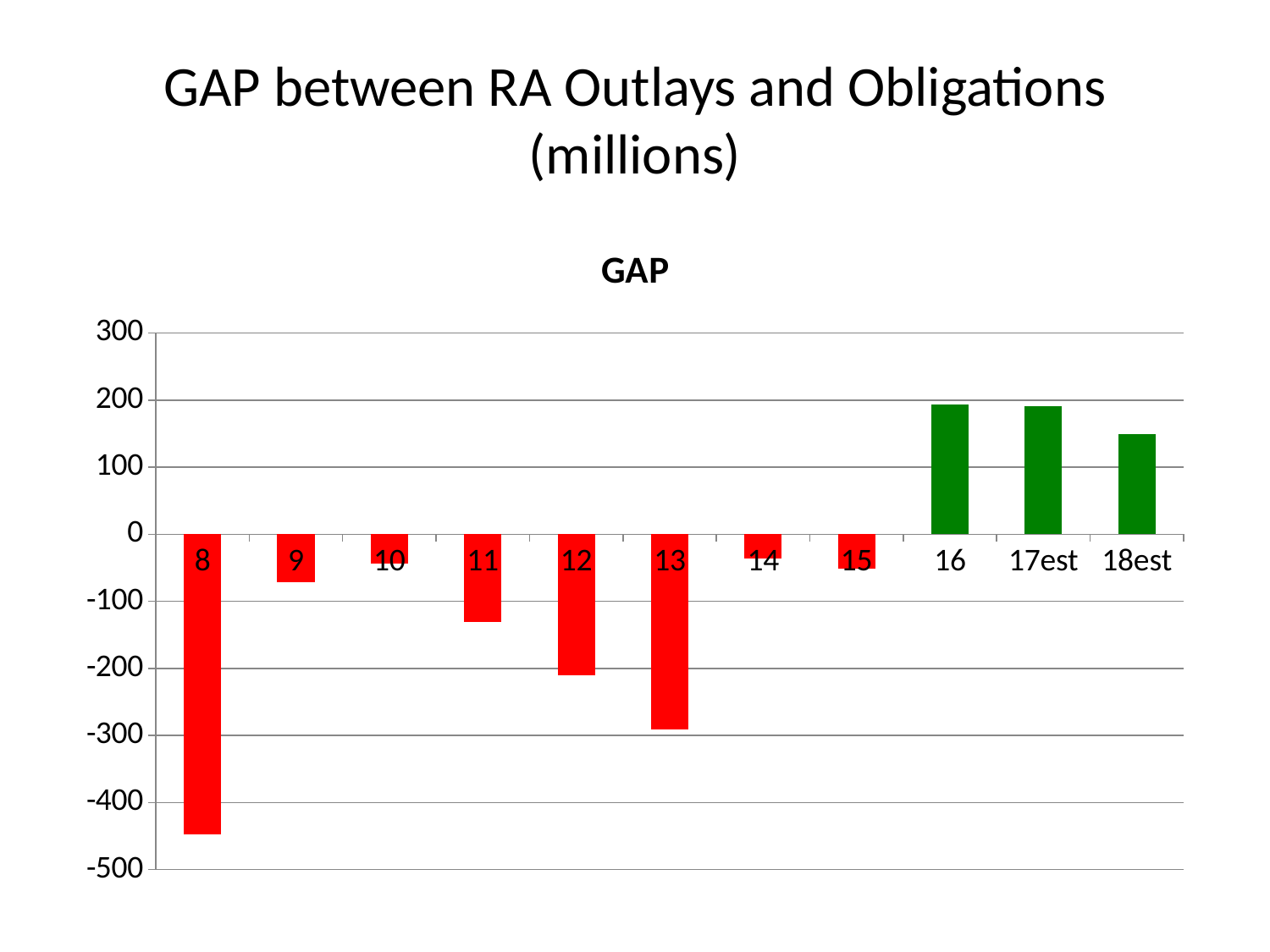
What kind of chart is shown on the slide? bar chart Is the value for 13 greater or less than -200? less Is the value for 18est greater or less than 100? greater How many categories are plotted along the x axis of the GAP chart? 11 Is the value for 9 greater or less than -100? greater What colour are the bars with positive values in the chart? green Which bar extends further below zero, 12 or 13? 13 Which value is larger, 16 or 18est? 16 Which category has the lowest value in the GAP chart? 8 What is the title shown directly above the chart plot area? GAP